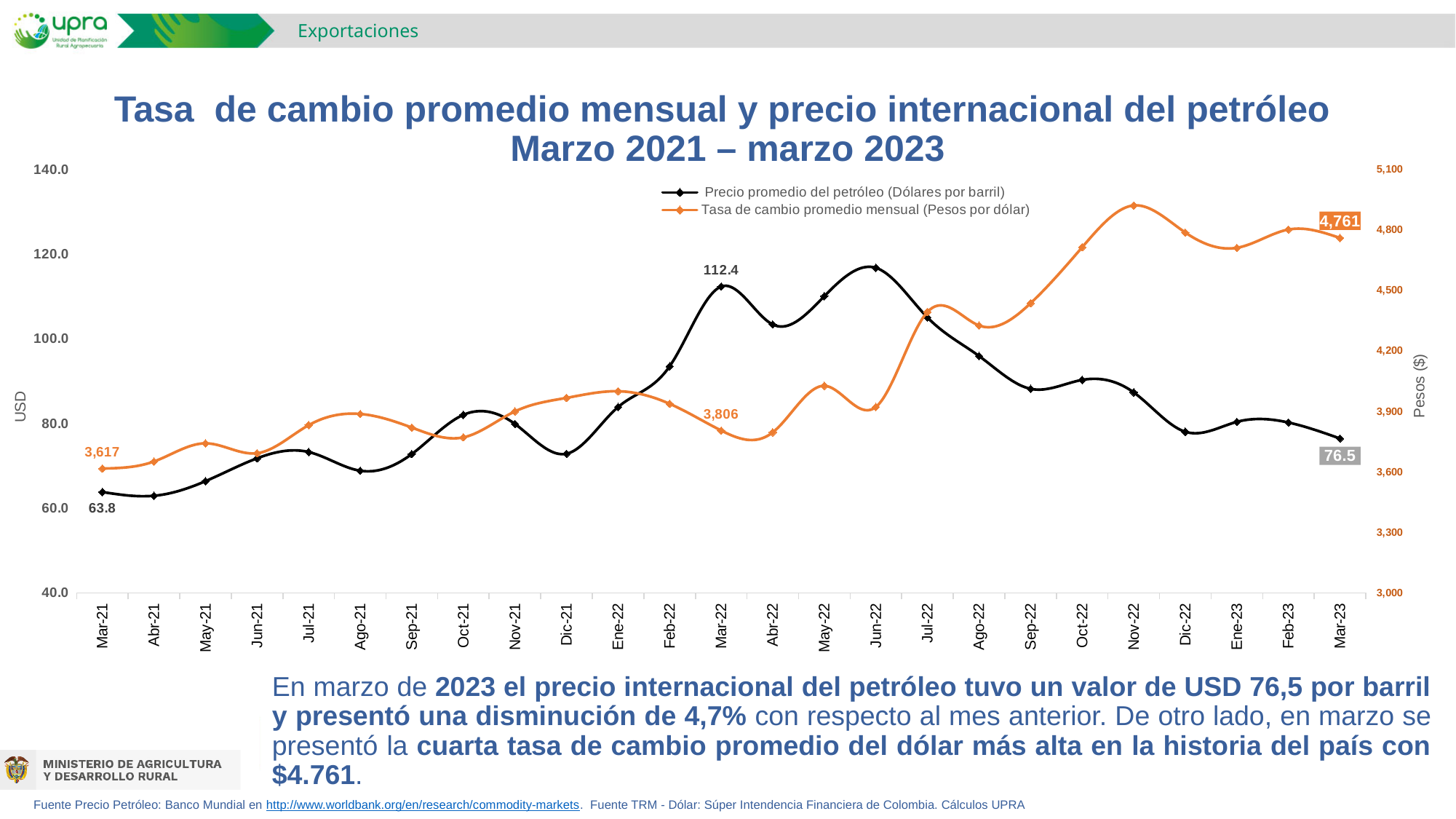
How many series does the legend list? 2 What is the value of Tasa de cambio promedio mensual for Mar-21? 3,617 What is the value of Tasa de cambio promedio mensual for Mar-23? 4,761 What is the value of Precio promedio del petróleo for Mar-22? 112.4 How many months are plotted along the x axis? 25 What kind of chart is shown on the slide? line chart What is the difference between the Precio promedio del petróleo in Mar-22 and in Mar-21? 48.6 What is the value of Precio promedio del petróleo for Mar-23? 76.5 By how much did the Tasa de cambio promedio mensual increase from Mar-21 to Mar-23? 1,144 What is the value of Precio promedio del petróleo for Mar-21? 63.8 Which is larger, the Precio promedio del petróleo in Mar-22 or in Mar-23? Mar-22 Is the value of Precio promedio del petróleo for Jun-22 greater or less than 100.0? greater